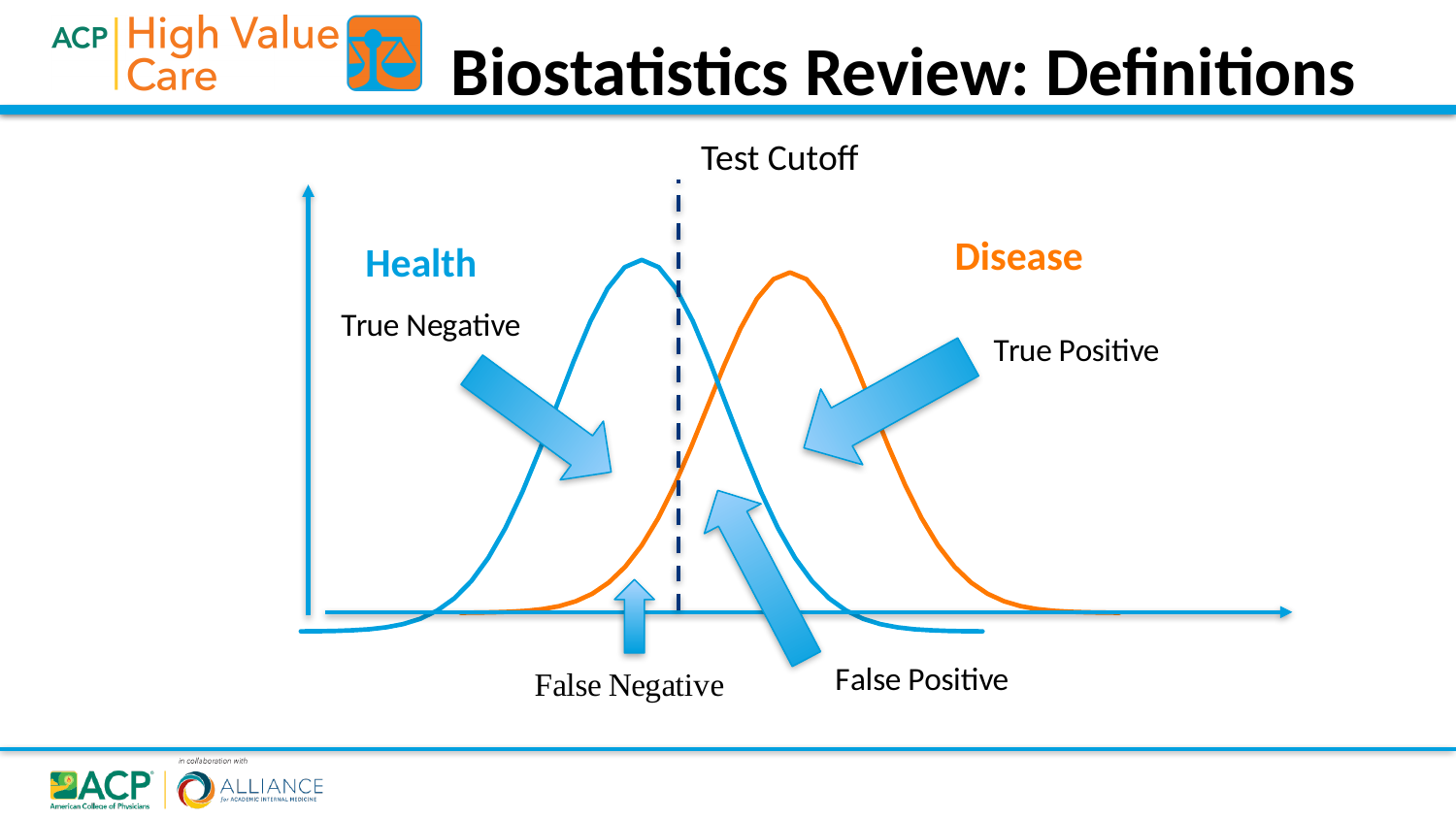
Which curve has its peak to the left of the Test Cutoff line, Health or Disease? Health What are the two curves on the chart labelled? Health and Disease What does the dashed vertical line on the chart represent? Test Cutoff How many curves are plotted on the chart? 2 Which curve has its peak to the right of the Test Cutoff line, Health or Disease? Disease What kind of chart is shown on the slide? line chart